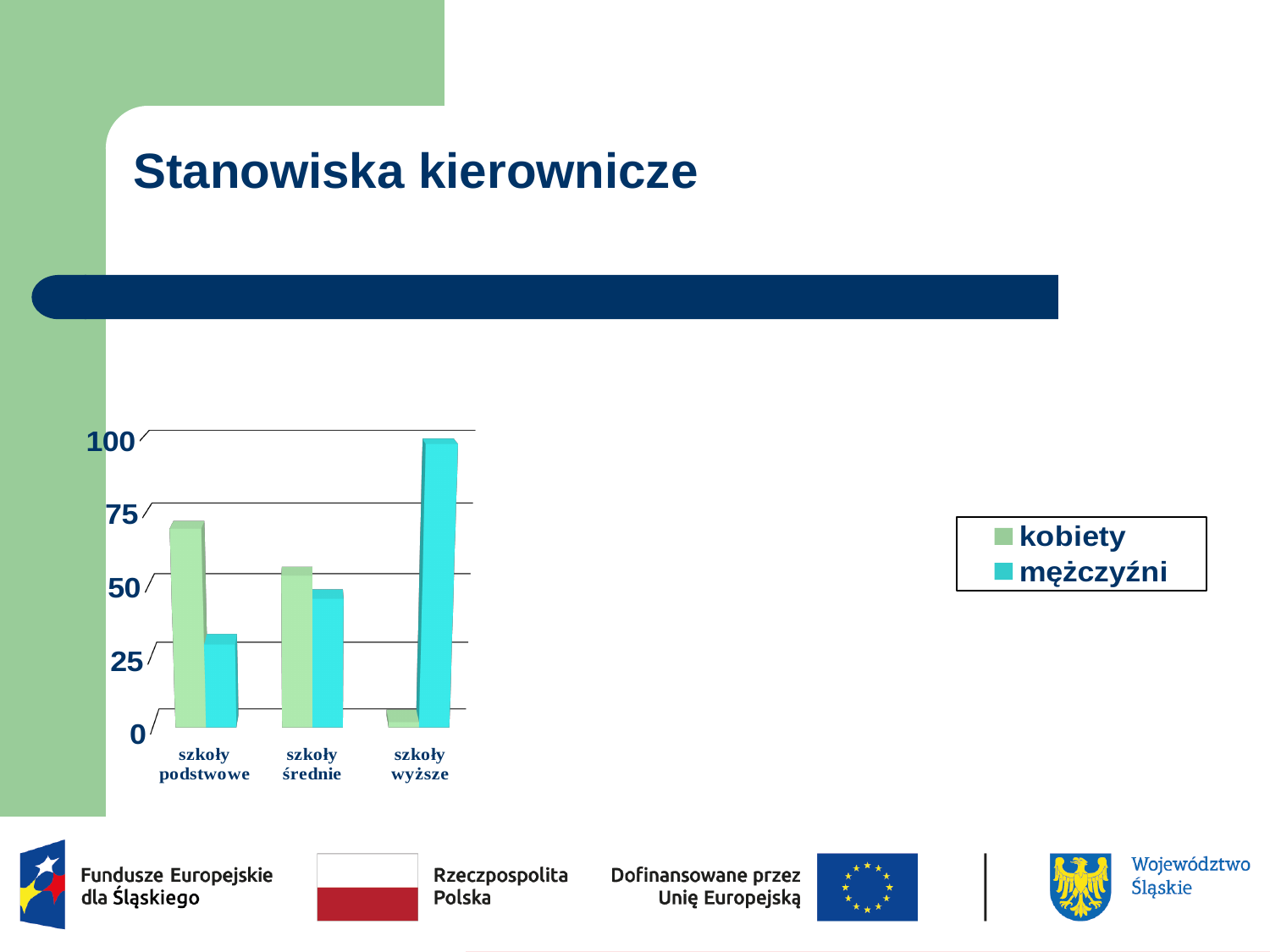
Which series is shown in light green in the chart? kobiety In which category is the value for kobiety lowest? szkoły wyższe Is the value for kobiety in szkoły podstawowe greater or less than 50? greater Is the value for kobiety in szkoły wyższe greater or less than 25? less Is the value for mężczyźni in szkoły podstawowe greater or less than 50? less What kind of chart is shown on the slide? bar chart In which category is the value for kobiety highest? szkoły podstwowe What is the title of the slide containing the chart? Stanowiska kierownicze How many categories are shown on the x axis of the chart? 3 In which category is the value for mężczyźni lowest? szkoły podstwowe How many series does the chart's legend list? 2 In which category is the value for mężczyźni highest? szkoły wyższe